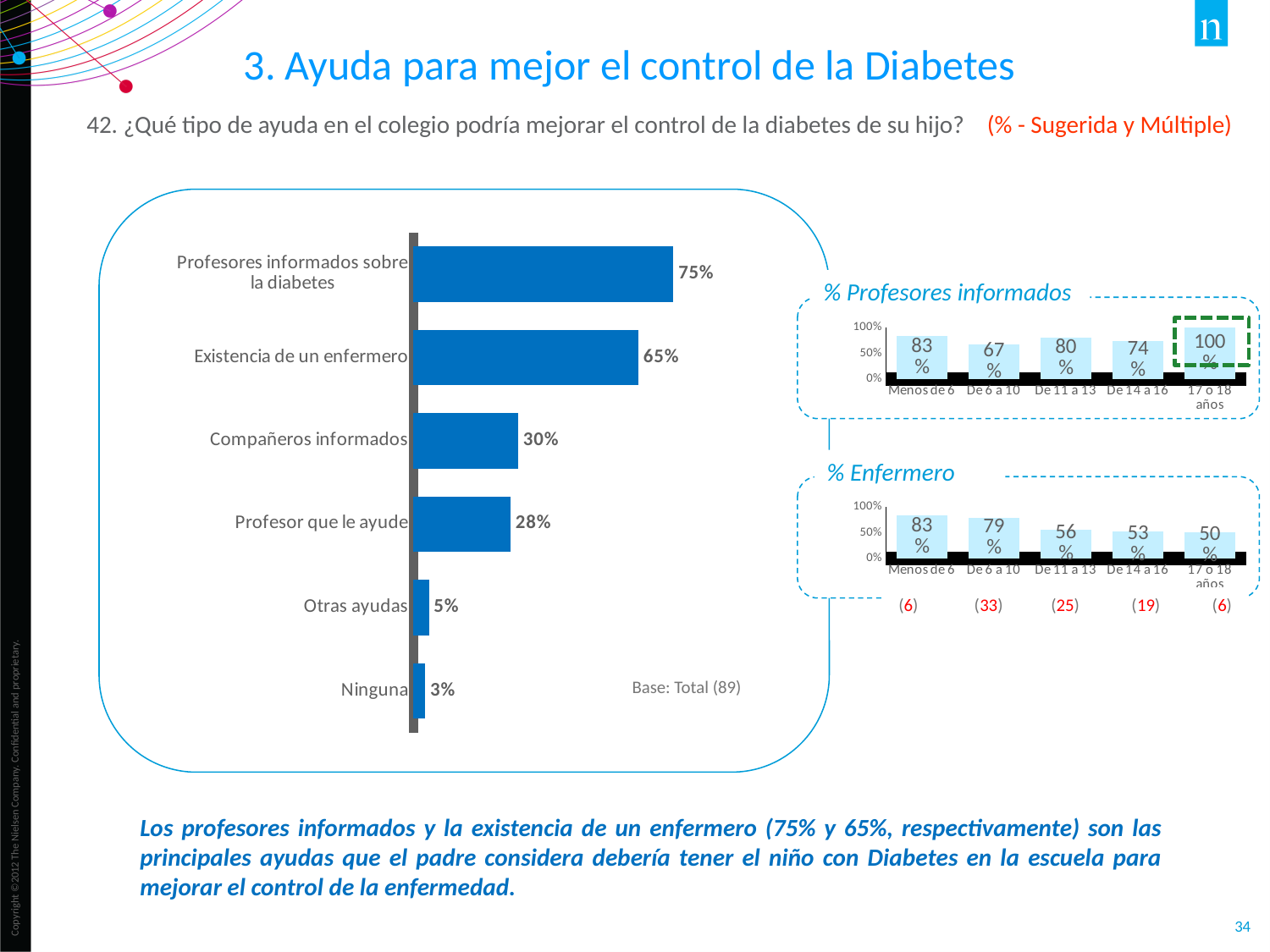
In the '% Profesores informados' chart, which age group has the lowest value? De 6 a 10 What type of chart is the main chart on the left? Bar chart In the '% Enfermero' chart, do the values rise or fall from 'Menos de 6' to '17 o 18 años'? Fall In the main bar chart on the left, what percentage is shown for 'Existencia de un enfermero'? 65% In the '% Profesores informados' chart, what is the value for '17 o 18 años'? 100% In the main bar chart on the left, what is the difference between 'Compañeros informados' and 'Profesor que le ayude'? 2% In the main bar chart on the left, which category has the highest value? Profesores informados sobre la diabetes In the main bar chart on the left, how many categories are shown? 6 In the '% Enfermero' chart, what is the difference between 'Menos de 6' and '17 o 18 años'? 33% In the main bar chart on the left, which category has the lowest value? Ninguna In the '% Enfermero' chart, what is the value for 'De 11 a 13'? 56% In the '% Profesores informados' chart, which is larger: 'De 11 a 13' or 'De 14 a 16'? De 11 a 13